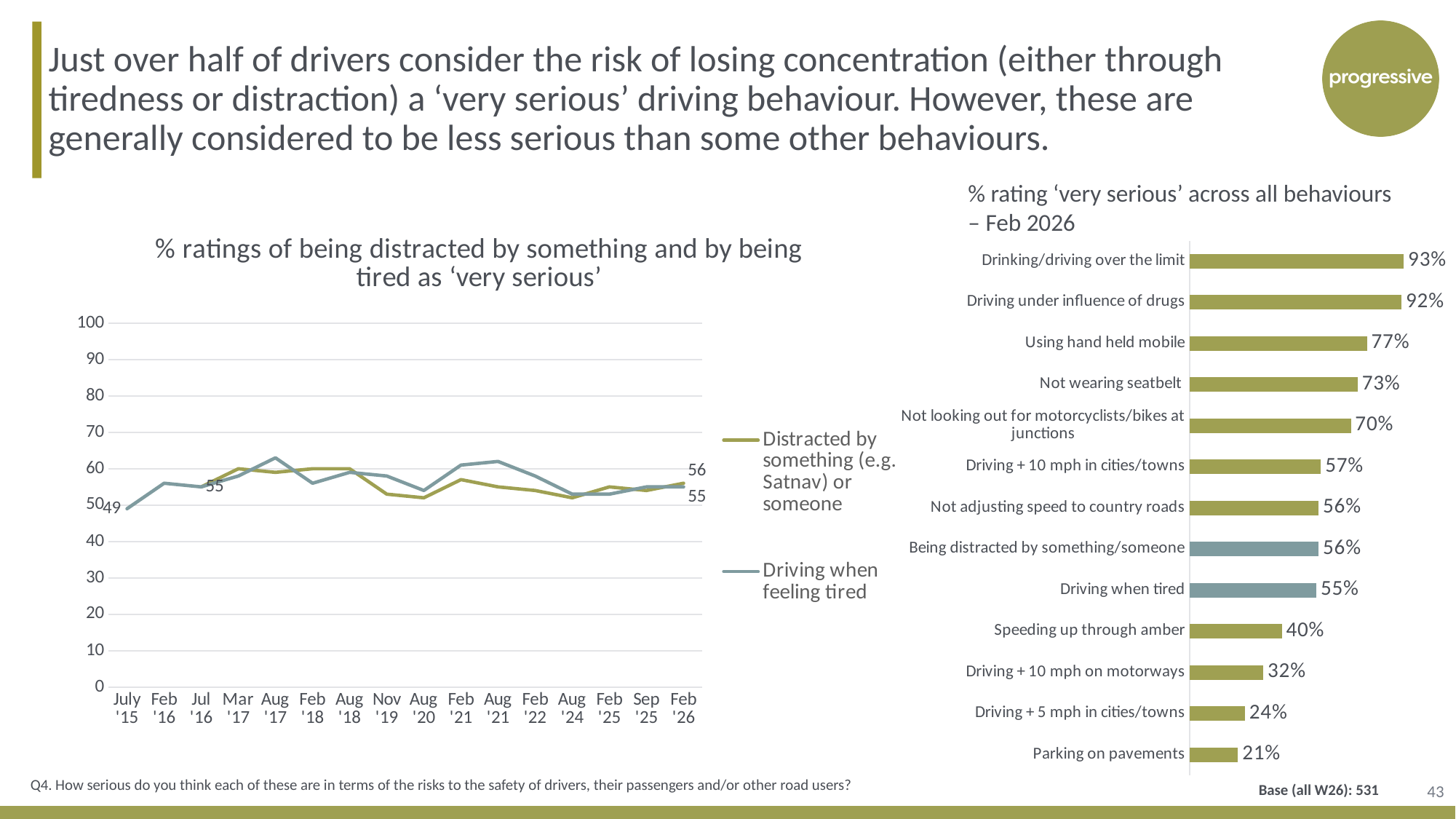
In the bar chart '% rating ‘very serious’ across all behaviours – Feb 2026', what is the value for Drinking/driving over the limit? 93% What kind of chart is the left-hand chart titled '% ratings of being distracted by something and by being tired as ‘very serious’'? Line chart In the bar chart '% rating ‘very serious’ across all behaviours – Feb 2026', which is larger: Speeding up through amber or Driving + 10 mph on motorways? Speeding up through amber In the bar chart '% rating ‘very serious’ across all behaviours – Feb 2026', what is the difference between Using hand held mobile and Not wearing seatbelt? 4 percentage points How many behaviours are listed in the bar chart '% rating ‘very serious’ across all behaviours – Feb 2026'? 13 How many series does the legend of the left-hand line chart list? 2 In the bar chart '% rating ‘very serious’ across all behaviours – Feb 2026', which behaviour has the highest value? Drinking/driving over the limit In the bar chart '% rating ‘very serious’ across all behaviours – Feb 2026', which behaviour has the lowest value? Parking on pavements In the left-hand line chart, what is the value for 'Distracted by something (e.g. Satnav) or someone' in Feb '26? 56 In the bar chart '% rating ‘very serious’ across all behaviours – Feb 2026', what is the value for Driving + 5 mph in cities/towns? 24% In the left-hand line chart, what is the value for 'Driving when feeling tired' in July '15? 49 In the left-hand line chart, is the value for 'Driving when feeling tired' in Aug '17 greater or less than 60? greater